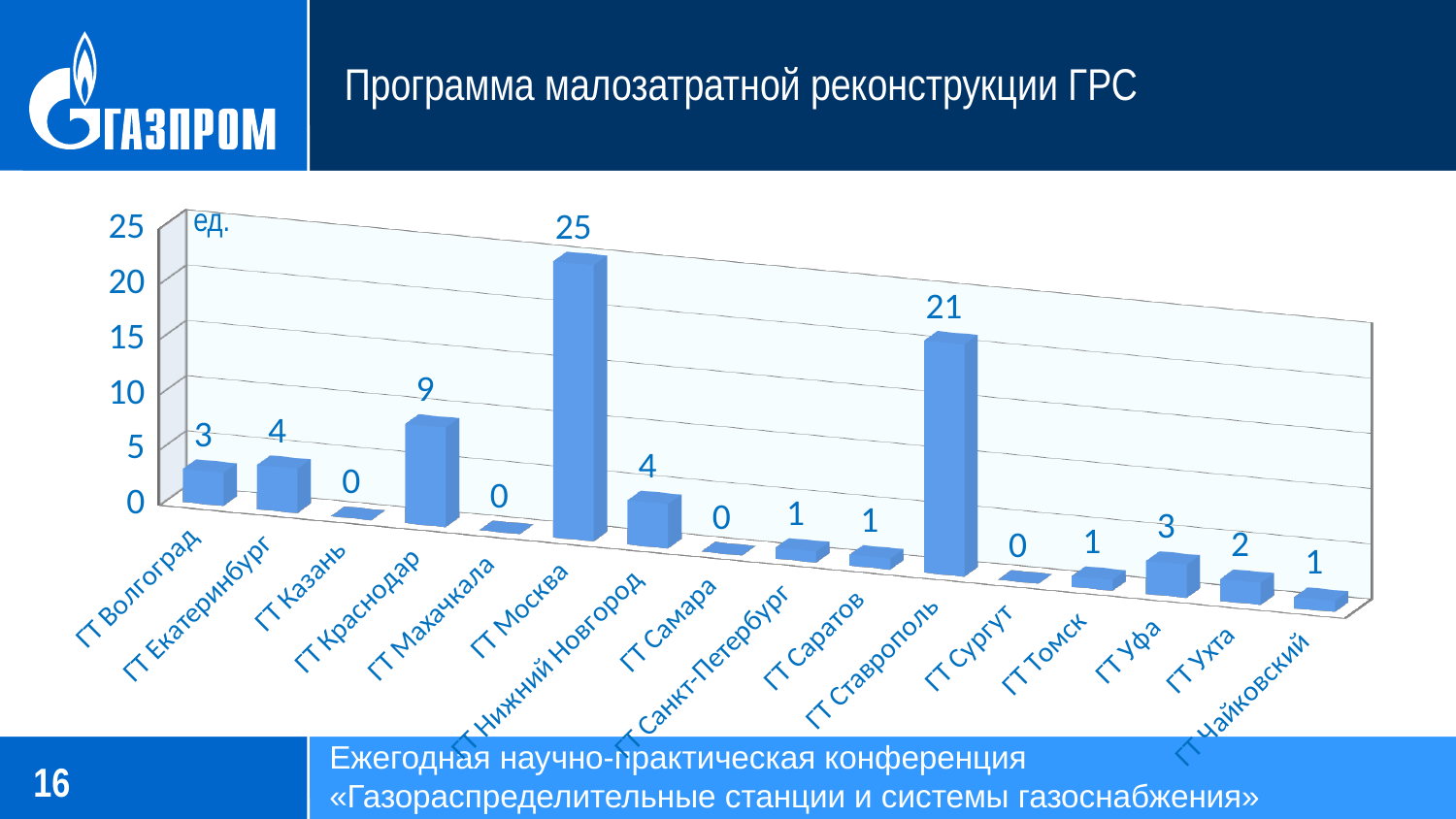
What value is shown for ГТ Ставрополь? 21 How many categories have a value of 0? 4 Which category has the highest value? ГТ Москва Which is larger, the value for ГТ Екатеринбург or the value for ГТ Уфа? ГТ Екатеринбург What value is shown for ГТ Краснодар? 9 What kind of chart is shown on the slide? Bar chart What value is shown for ГТ Ухта? 2 Is the value for ГТ Ставрополь greater or less than 20? greater What is the difference between the values for ГТ Москва and ГТ Ставрополь? 4 What value is shown for ГТ Москва? 25 How many categories are shown on the x axis? 16 What is the difference between the values for ГТ Краснодар and ГТ Волгоград? 6